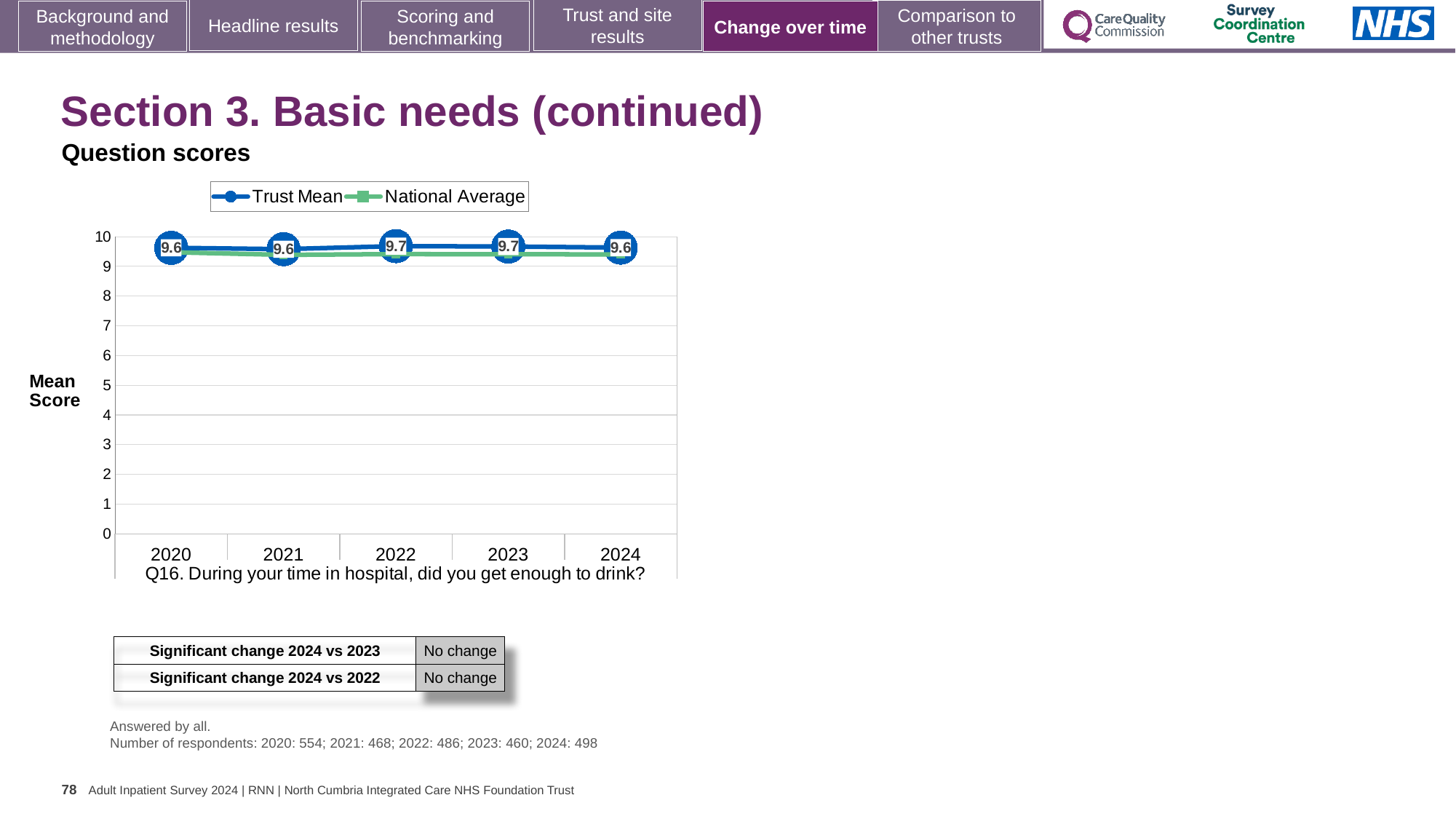
What is the Trust Mean score for 2024? 9.6 What is the Trust Mean score for 2023? 9.7 What is the Trust Mean score for 2020? 9.6 What is the label of the y axis of the chart? Mean Score Is the Trust Mean value for 2021 greater or less than 9? greater What is the difference between the Trust Mean score in 2022 and in 2021? 0.1 What kind of chart is shown on the slide? Line chart Is the National Average value for 2024 greater or less than 9? greater How many years are plotted on the x axis of the chart? 5 Which series is shown in blue in the chart legend? Trust Mean How many series does the chart legend list? 2 What is the Trust Mean score for 2022? 9.7